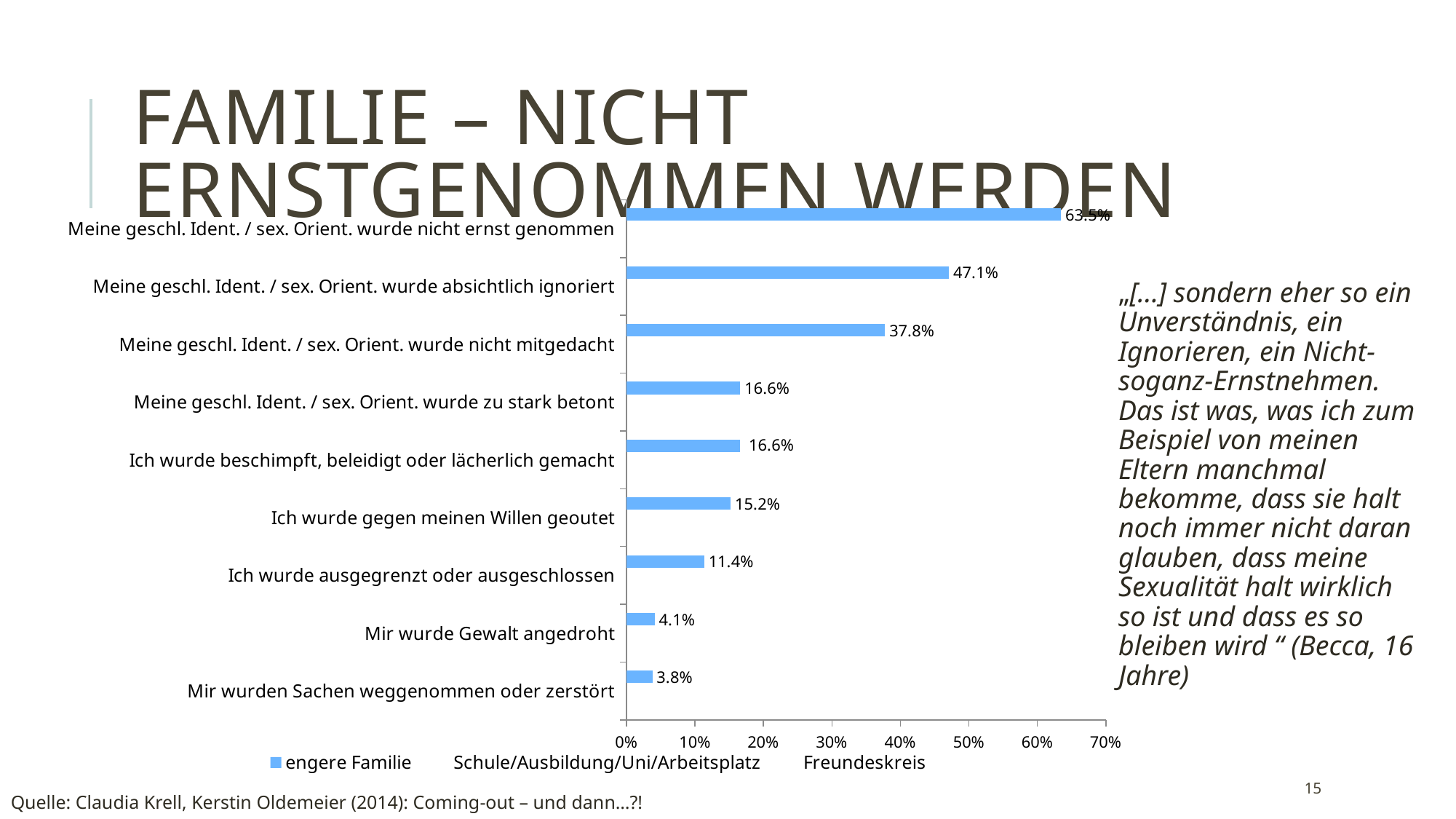
What is the difference between the values for "wurde nicht ernst genommen" and "wurde absichtlich ignoriert"? 16.4 percentage points What is the value for "Meine geschl. Ident. / sex. Orient. wurde nicht ernst genommen"? 63.5% Which is larger: the value for "Ich wurde gegen meinen Willen geoutet" or for "Ich wurde ausgegrenzt oder ausgeschlossen"? Ich wurde gegen meinen Willen geoutet Which legend entry is shown with the blue marker? engere Familie What is the value for "Meine geschl. Ident. / sex. Orient. wurde nicht mitgedacht"? 37.8% Which category has the highest value? Meine geschl. Ident. / sex. Orient. wurde nicht ernst genommen What is the difference between the values for "wurde nicht mitgedacht" and "wurde zu stark betont"? 21.2 percentage points Which category has the lowest value? Mir wurden Sachen weggenommen oder zerstört How many categories are shown in the chart? 9 What is the value for "Meine geschl. Ident. / sex. Orient. wurde absichtlich ignoriert"? 47.1% What kind of chart is shown on the slide? Bar chart What is the value for "Mir wurde Gewalt angedroht"? 4.1%